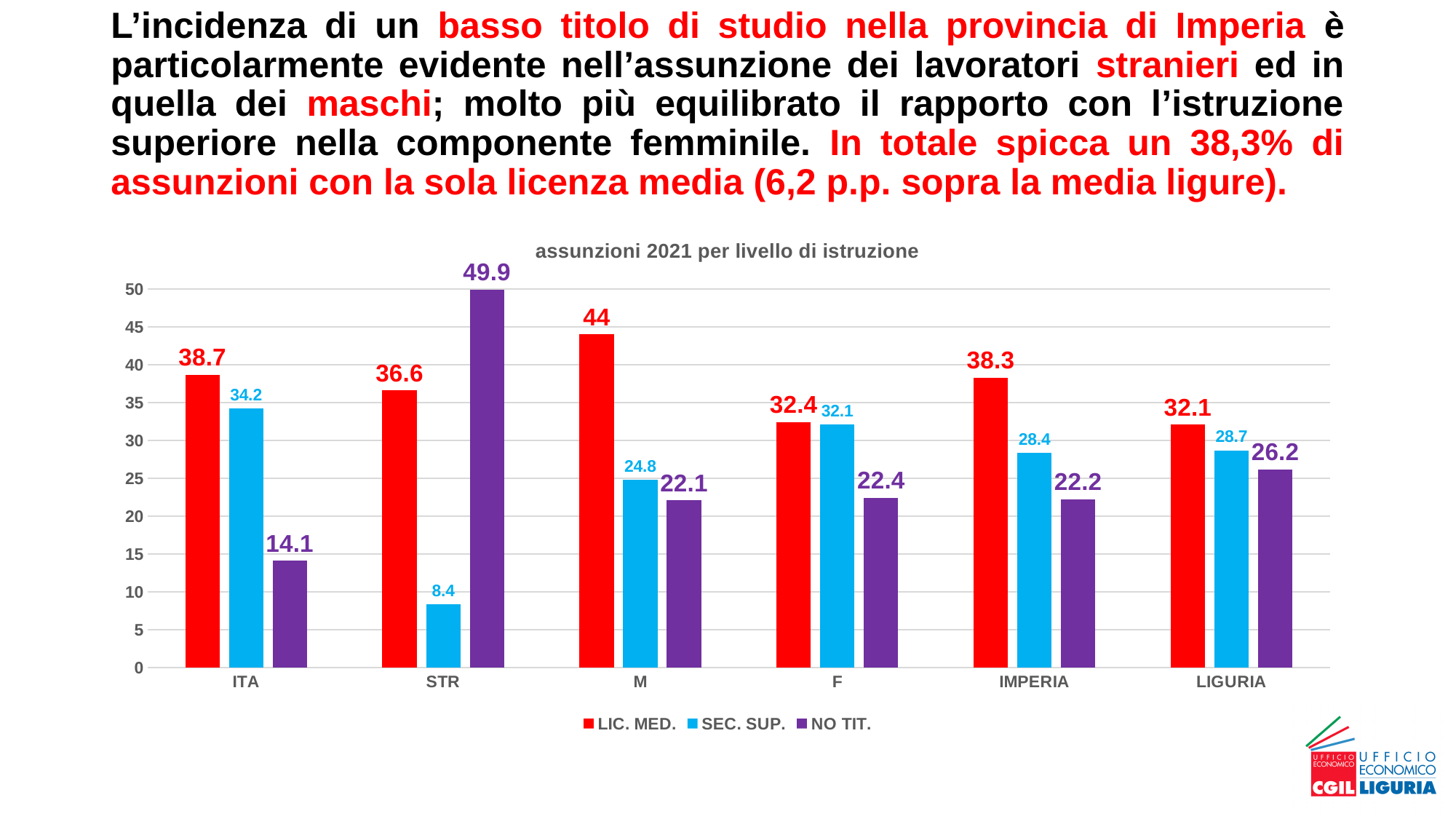
What is the NO TIT. value for STR? 49.9 What is the difference between the LIC. MED. values for IMPERIA and LIGURIA? 6.2 How many series does the legend list? 3 Which category has the lowest SEC. SUP. value? STR Which colour represents the NO TIT. series? purple Which is larger, the NO TIT. value for ITA or for LIGURIA? LIGURIA What is the LIC. MED. value for IMPERIA? 38.3 Which category has the highest LIC. MED. value? M How many categories are shown on the x axis? 6 What kind of chart is shown on the slide? bar chart What is the SEC. SUP. value for LIGURIA? 28.7 What is the title of the chart? assunzioni 2021 per livello di istruzione